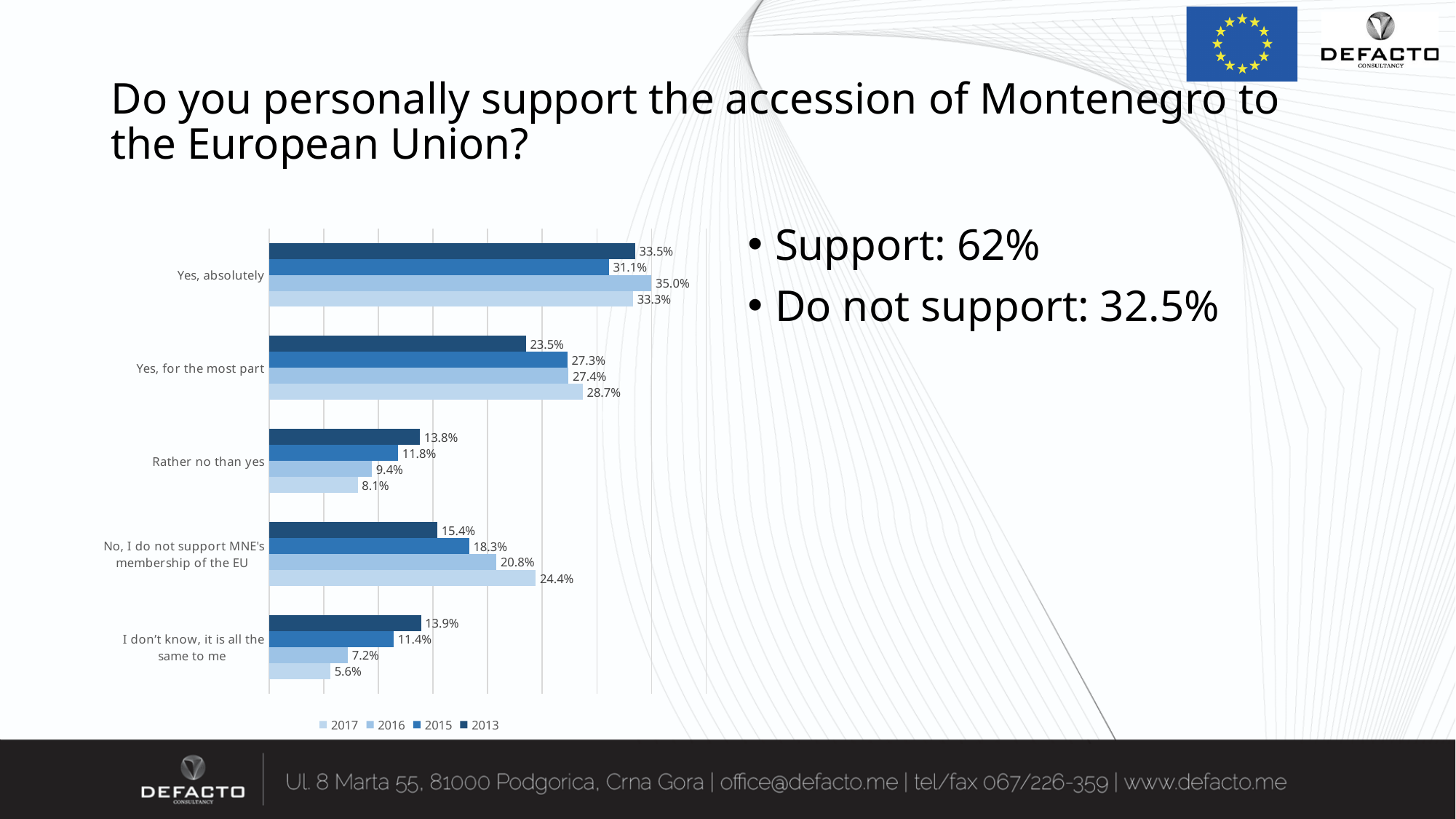
Which response category has the lowest 2017 value? I don't know, it is all the same to me How many series does the chart legend list? 4 What type of chart is shown on the slide? bar chart How many response categories are shown in the chart? 5 What is the 2016 value for "I don't know, it is all the same to me"? 7.2% Which years are listed in the chart legend? 2017, 2016, 2015, 2013 What is the 2013 value for "No, I do not support MNE's membership of the EU"? 15.4% What is the 2017 value for "Yes, absolutely"? 33.3% What is the difference between the 2017 and 2013 values for "No, I do not support MNE's membership of the EU"? 9.0% For "Rather no than yes", which year has the larger value, 2013 or 2017? 2013 How does the value for "I don't know, it is all the same to me" change from 2013 to 2017? It falls Which response category has the highest 2017 value? Yes, absolutely